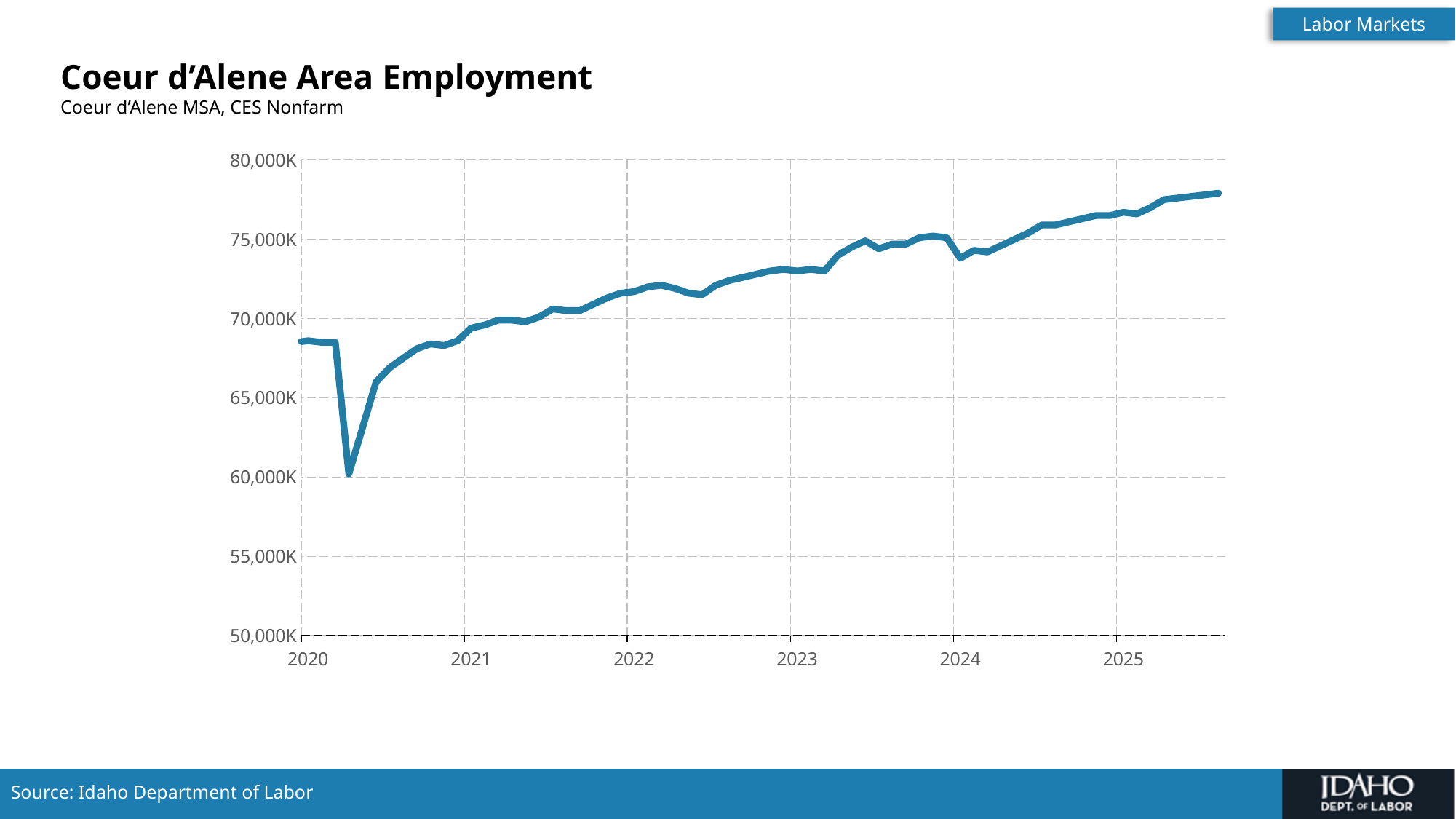
Overall, does employment rise or fall from 2020 to 2025? rise Which is larger, the value at the start of 2020 or the value at the start of 2021? 2021 Is the lowest point of the line in 2020 greater or less than 65,000K? less Is the value at the start of 2023 greater or less than 75,000K? less Is the value at the start of 2025 greater or less than 75,000K? greater What subtitle appears under the chart title? Coeur d'Alene MSA, CES Nonfarm In which year does the line reach its highest point? 2025 What kind of chart is shown on the slide? line chart Which is larger, the value at the start of 2022 or the value at the start of 2024? 2024 In which year does the line reach its lowest point? 2020 What is the title of the chart on the slide? Coeur d'Alene Area Employment